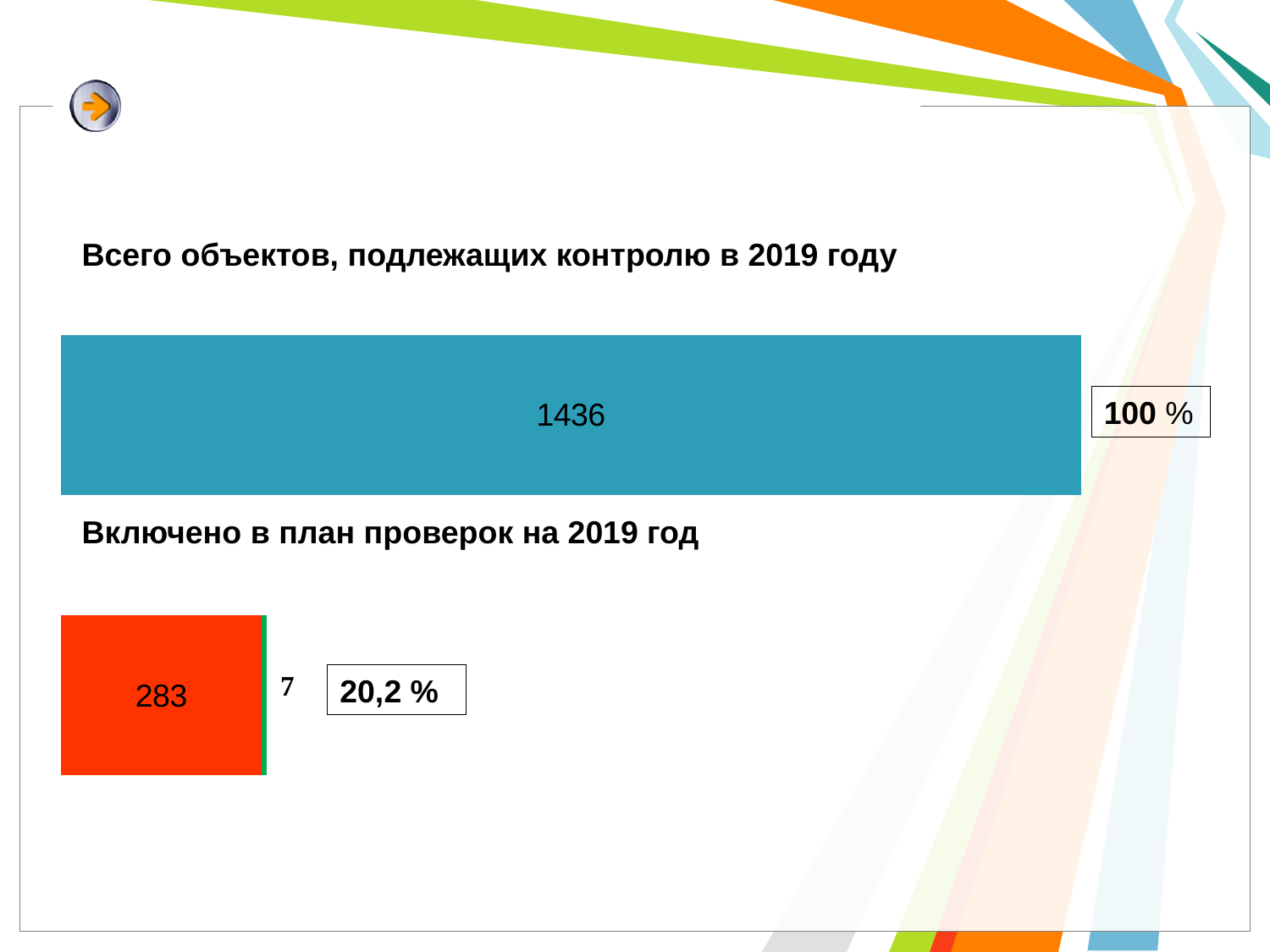
What value is labelled on the small green segment at the end of the "Включено в план проверок на 2019 год" bar? 7 What value is shown on the bar for "Всего объектов, подлежащих контролю в 2019 году"? 1436 What is the difference between the value 1436 for "Всего объектов, подлежащих контролю в 2019 году" and the value 283 for "Включено в план проверок на 2019 год"? 1153 Which category has the larger value: "Всего объектов, подлежащих контролю в 2019 году" or "Включено в план проверок на 2019 год"? Всего объектов, подлежащих контролю в 2019 году What is the total of the "Включено в план проверок на 2019 год" bar, combining the red segment (283) and the green segment (7)? 290 How many categories (bars) are shown on the chart? 2 What value is shown on the red bar for "Включено в план проверок на 2019 год"? 283 What percentage is shown next to the bar for "Включено в план проверок на 2019 год"? 20,2 % What colour is the bar for "Всего объектов, подлежащих контролю в 2019 году"? blue What percentage is shown next to the bar for "Всего объектов, подлежащих контролю в 2019 году"? 100 % Which category has the smallest value on the chart? Включено в план проверок на 2019 год What kind of chart is shown on the slide? bar chart